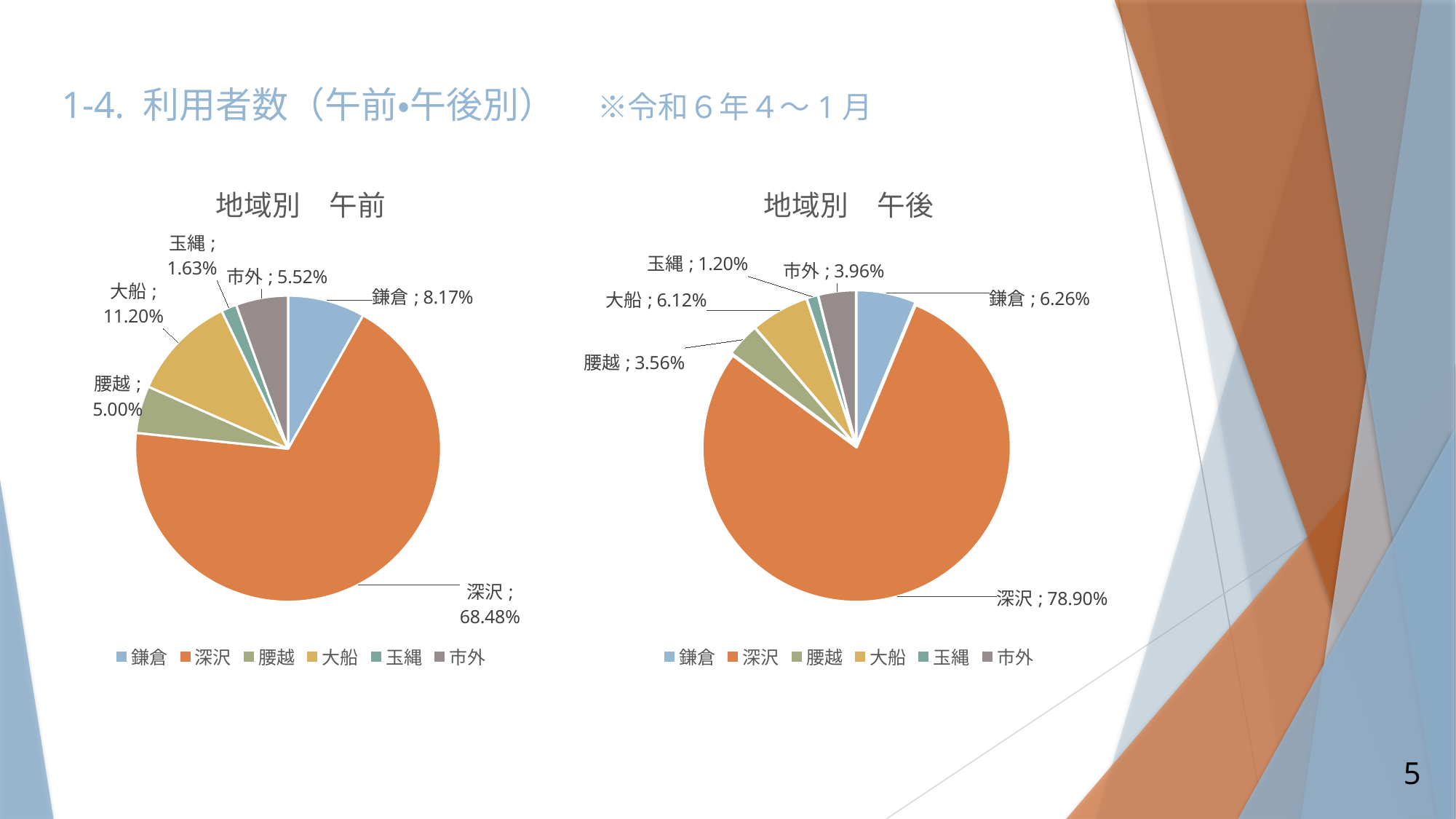
In the 地域別 午前 chart, what is the share for 深沢? 68.48% How many categories does the 地域別 午後 chart show? 6 In the 地域別 午前 chart, which category has the largest share? 深沢 In the 地域別 午後 chart, what is the share for 鎌倉? 6.26% In the 地域別 午前 chart, what is the share for 大船? 11.20% What kind of chart is the 地域別 午前 chart? Pie chart What is the difference between the 深沢 share in the 地域別 午後 chart and the 深沢 share in the 地域別 午前 chart? 10.42% In the 地域別 午後 chart, which category has the smallest share? 玉縄 In the 地域別 午前 chart, which category has the smallest share? 玉縄 In the 地域別 午後 chart, what is the share for 市外? 3.96% What is the title of the chart on the right side of the slide? 地域別 午後 In the 地域別 午前 chart, which is larger, the share for 腰越 or the share for 市外? 市外